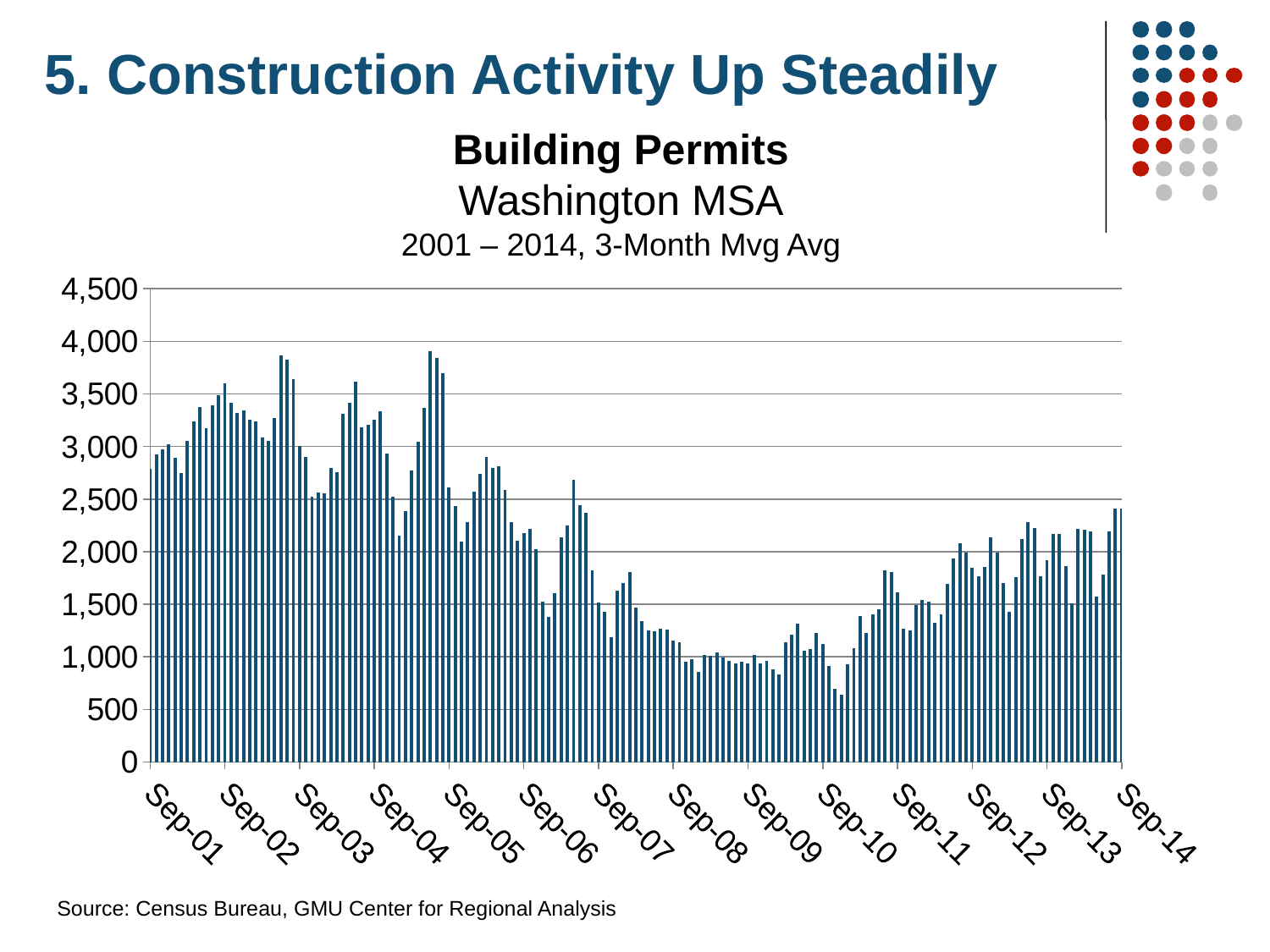
Is the value for Sep-01 greater or less than 2,500? greater Is the value for Sep-04 greater or less than 2,500? greater Do the values generally rise or fall between Sep-04 and Sep-09? fall What kind of chart is shown on the slide? bar chart Is the value for Sep-09 greater or less than 1,500? less How many labelled dates appear along the x axis of the chart? 14 What is the title of the chart? Building Permits Which is larger, the value for Sep-01 or the value for Sep-09? Sep-01 Do the values generally rise or fall between Sep-09 and Sep-14? rise What is the highest value shown on the vertical axis of the chart? 4,500